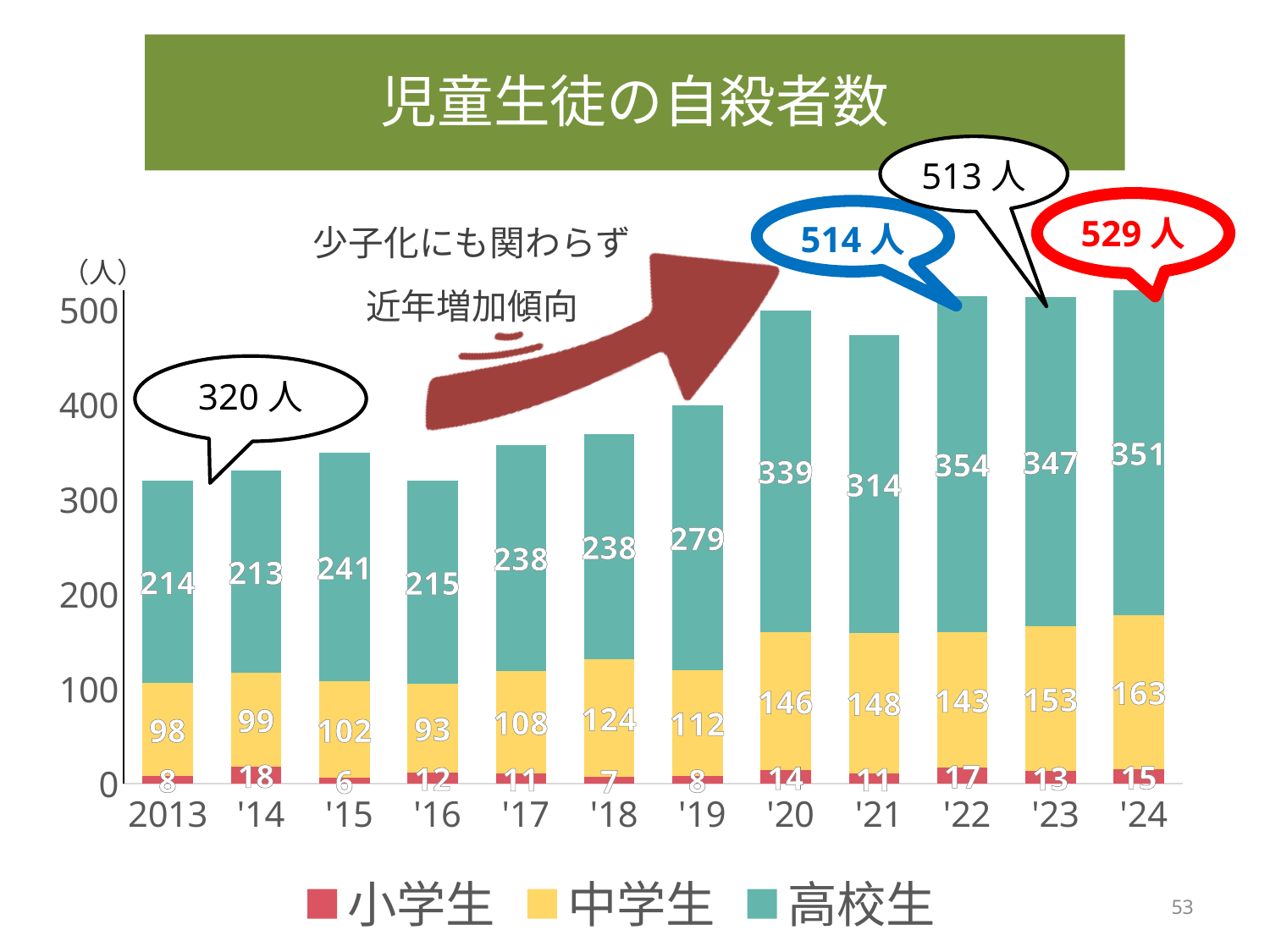
What is the total of the stacked bar for '24? 529 What is the value for 中学生 in 2013? 98 What is the value for 高校生 in '24? 351 What is the value for 小学生 in '14? 18 What is the difference between the 中学生 values for '24 and '23? 10 What is the total of the stacked bar for 2013? 320 Which year has the highest value for 高校生? '22 Which year has the lowest value for 小学生? '15 Which is larger, the 高校生 value for '20 or for '21? '20 How many years are shown on the x axis? 12 What kind of chart is shown on the slide? Stacked bar chart How many series does the legend list? 3